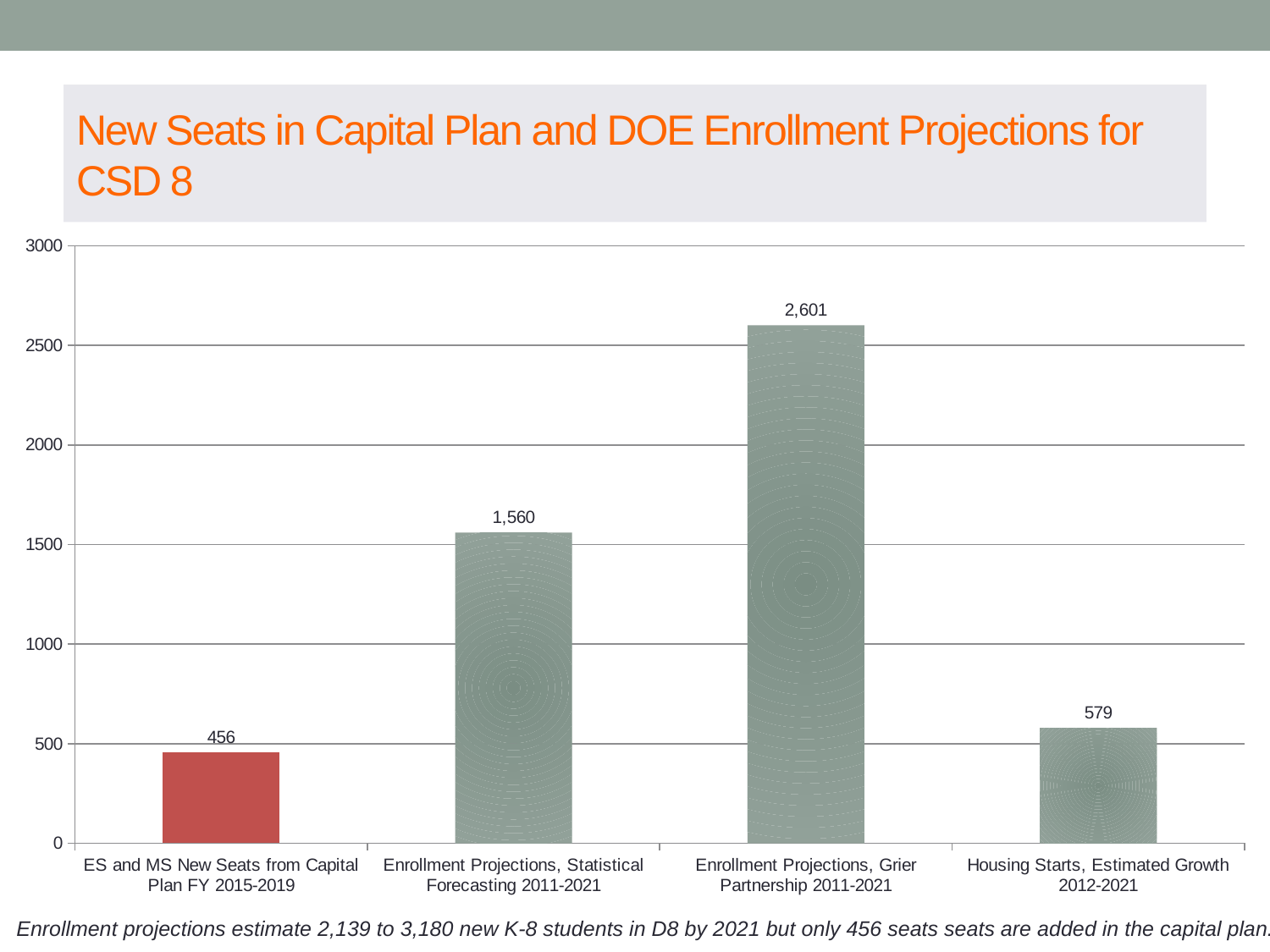
What is the value for ES and MS New Seats from Capital Plan FY 2015-2019? 456 How many categories are shown on the chart? 4 Which category has the highest value? Enrollment Projections, Grier Partnership 2011-2021 What is the value for Housing Starts, Estimated Growth 2012-2021? 579 What kind of chart is shown on the slide? Bar chart Which bar is coloured differently (red) from the others? ES and MS New Seats from Capital Plan FY 2015-2019 Which is larger: Housing Starts, Estimated Growth 2012-2021 or ES and MS New Seats from Capital Plan FY 2015-2019? Housing Starts, Estimated Growth 2012-2021 Which category has the lowest value? ES and MS New Seats from Capital Plan FY 2015-2019 What is the value for Enrollment Projections, Statistical Forecasting 2011-2021? 1,560 What is the value for Enrollment Projections, Grier Partnership 2011-2021? 2,601 What is the difference between Housing Starts, Estimated Growth 2012-2021 and ES and MS New Seats from Capital Plan FY 2015-2019? 123 What is the difference between the Grier Partnership projection and the Statistical Forecasting projection? 1,041